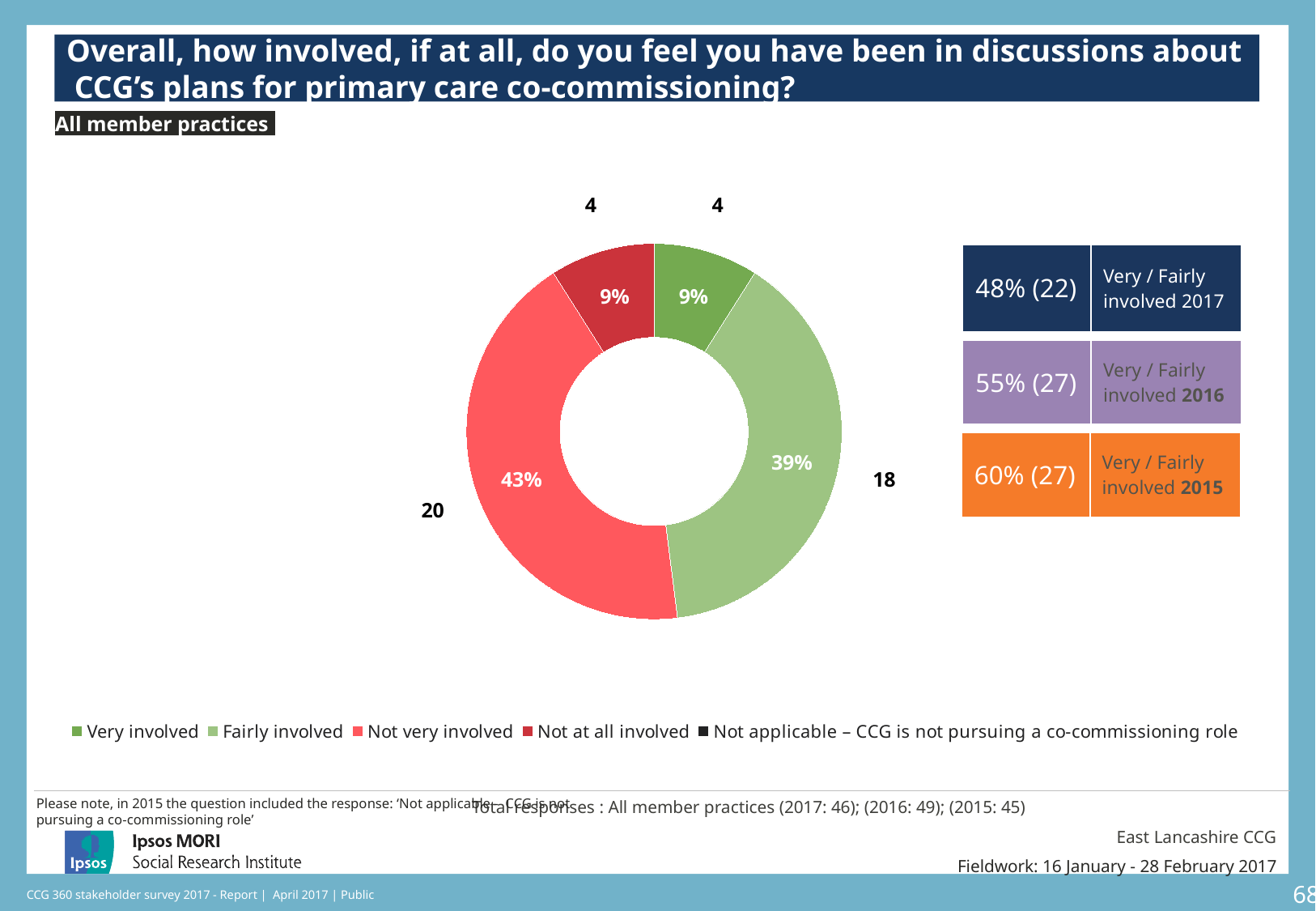
Which response category has the largest share of the donut chart? Not very involved What is the combined percentage for 'Very involved' and 'Fairly involved' in 2017, as shown in the box to the right of the chart? 48% (22) How many entries does the legend list? 5 What percentage of respondents said they were 'Very involved'? 9% What is the difference in percentage points between 'Not very involved' and 'Fairly involved'? 4 What percentage of respondents said they were 'Not very involved'? 43% What colour is used for the 'Not very involved' segment? Red (coral) What percentage of respondents said they were 'Fairly involved'? 39% Which is larger: the share for 'Fairly involved' or the share for 'Not at all involved'? Fairly involved How many respondents (count) said they were 'Not very involved'? 20 How many respondents (count) said they were 'Fairly involved'? 18 What type of chart is shown on the slide? Donut (pie) chart